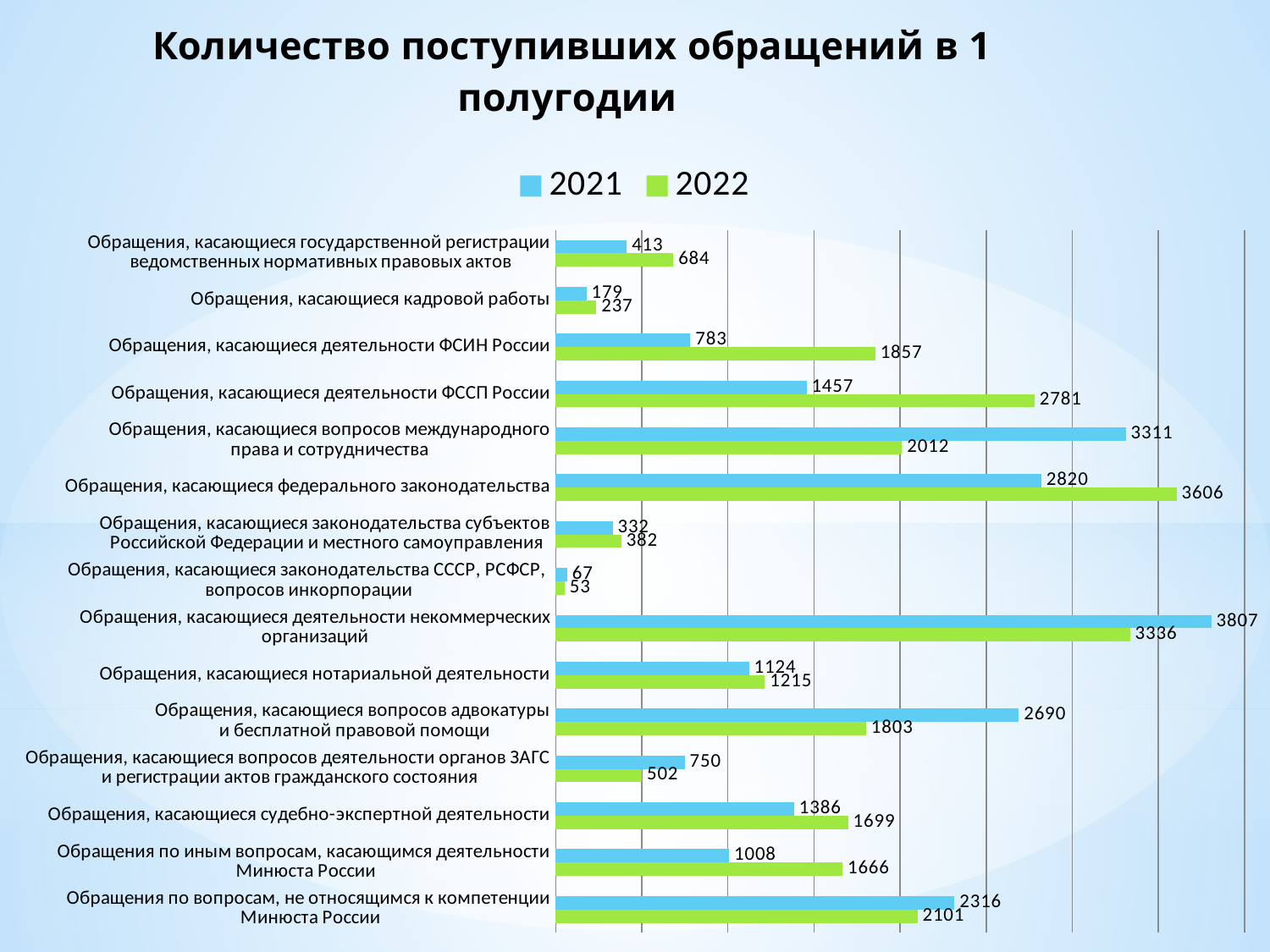
What is the difference between the 2021 and 2022 values for 'Обращения, касающиеся вопросов деятельности органов ЗАГС и регистрации актов гражданского состояния'? 248 Which category has the highest 2021 value? Обращения, касающиеся деятельности некоммерческих организаций For 'Обращения, касающиеся вопросов международного права и сотрудничества', which year has the larger value, 2021 or 2022? 2021 Which category has the highest 2022 value? Обращения, касающиеся федерального законодательства How many categories are shown on the chart? 15 What type of chart is shown on the slide? bar chart Which colour represents the 2022 series in the chart? green What is the 2021 value for 'Обращения, касающиеся вопросов адвокатуры и бесплатной правовой помощи'? 2690 Which category has the lowest 2022 value? Обращения, касающиеся законодательства СССР, РСФСР, вопросов инкорпорации What is the difference between the 2022 and 2021 values for 'Обращения, касающиеся деятельности ФССП России'? 1324 How many series does the legend list? 2 What is the 2022 value for 'Обращения, касающиеся деятельности ФСИН России'? 1857